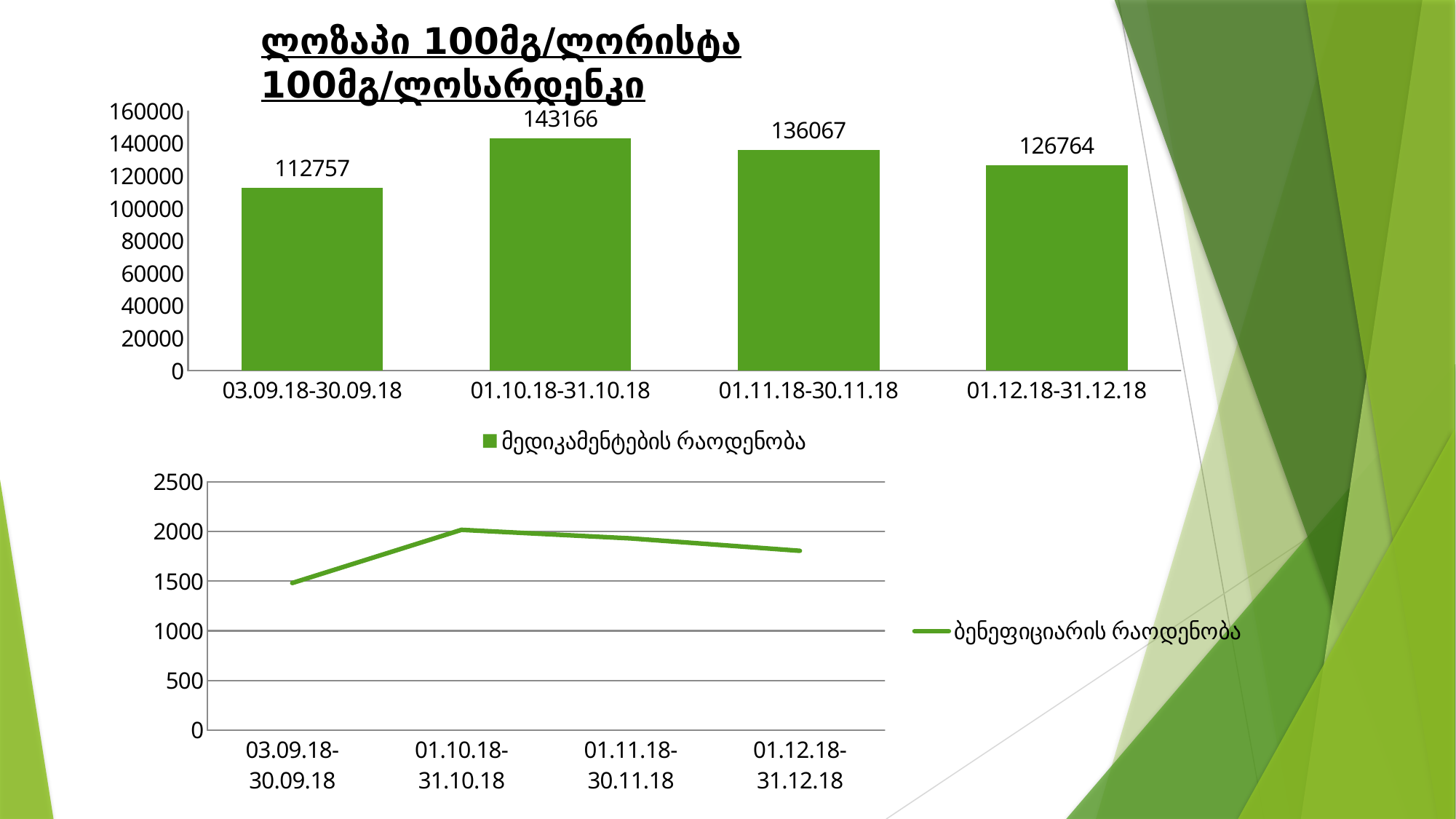
In the bottom line chart, does the line rise or fall from 01.10.18-31.10.18 to 01.12.18-31.12.18? fall In the top bar chart, what is the difference between the values for 01.10.18-31.10.18 and 01.11.18-30.11.18? 7099 How many bars are in the top bar chart? 4 In the top bar chart, what is the value for 01.12.18-31.12.18? 126764 What kind of chart is the bottom chart on the slide? line chart In the top bar chart, which period has the highest value? 01.10.18-31.10.18 In the top bar chart, which is larger: the value for 01.11.18-30.11.18 or for 01.12.18-31.12.18? 01.11.18-30.11.18 In the top bar chart, what is the value for 01.10.18-31.10.18? 143166 In the top bar chart, which period has the lowest value? 03.09.18-30.09.18 In the top bar chart, what is the value for 03.09.18-30.09.18? 112757